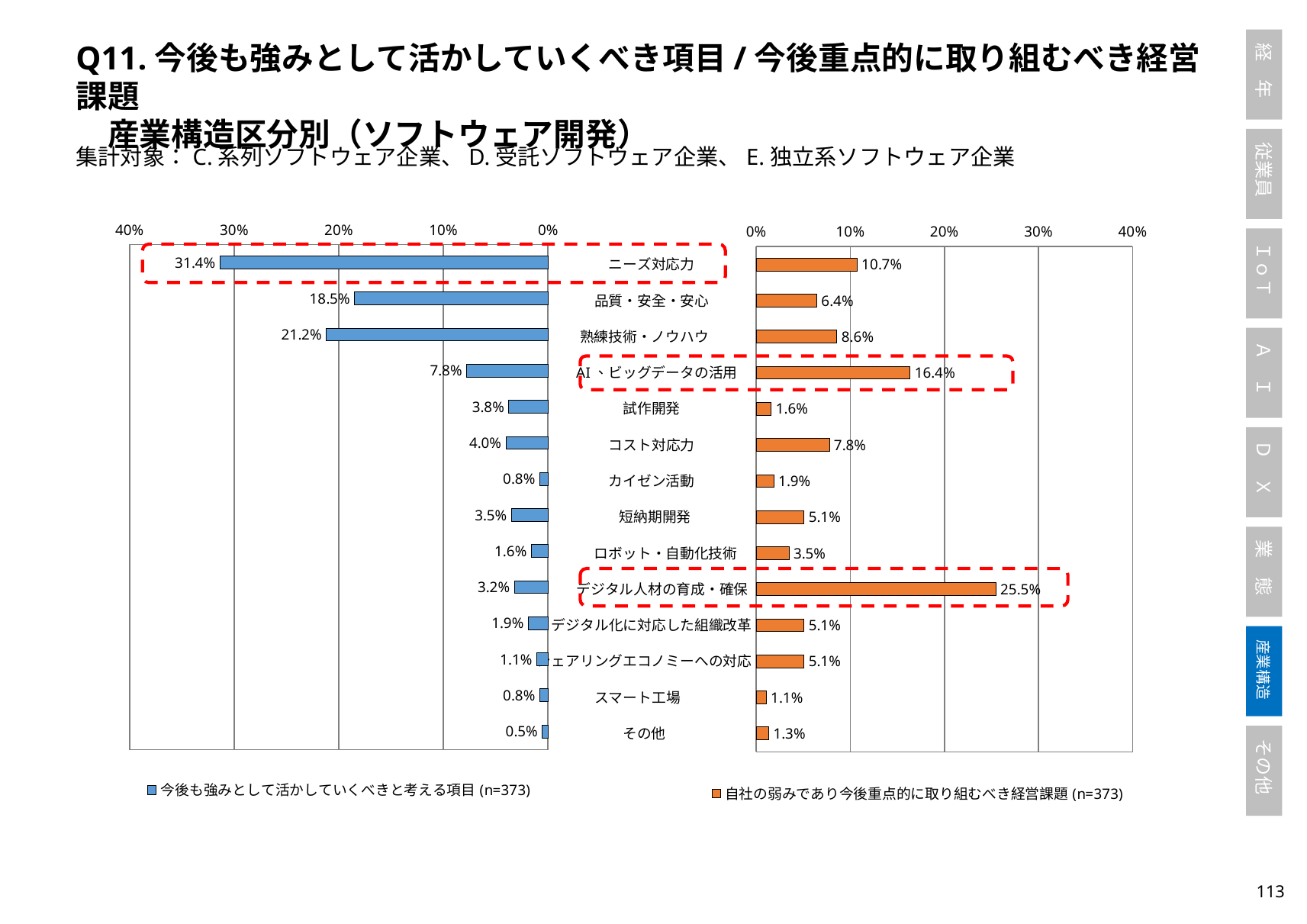
In the right chart, what is the difference between デジタル人材の育成・確保 and ニーズ対応力? 14.8% In the right chart, is the value for コスト対応力 greater or less than 10%? less What type of chart is the right chart? bar chart In the left chart, what is the difference between 熟練技術・ノウハウ and 品質・安全・安心? 2.7% In the left chart, which category has the lowest value? その他 In the right chart, which category has the highest value? デジタル人材の育成・確保 How many categories are shown in the left chart? 14 What is the sample size (n) shown in the legend of the left chart? n=373 In the left chart, which is larger: 熟練技術・ノウハウ or 品質・安全・安心? 熟練技術・ノウハウ In the right chart (自社の弱みであり今後重点的に取り組むべき経営課題), what is the value for AI、ビッグデータの活用? 16.4% In the left chart (今後も強みとして活かしていくべきと考える項目), what is the value for ニーズ対応力? 31.4% In the right chart, which category has the lowest value? スマート工場